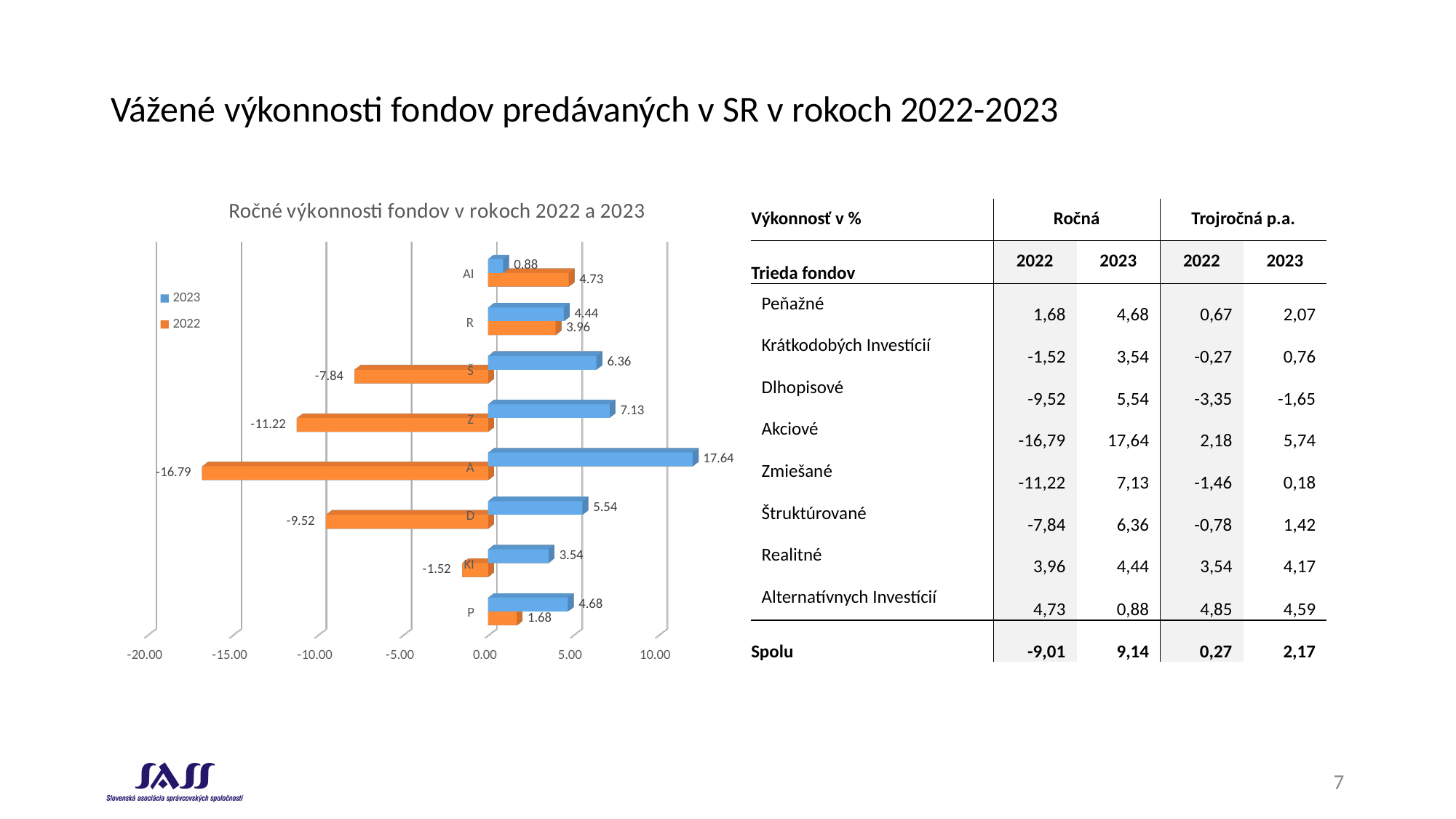
What type of chart is shown on the slide? Bar chart How many series does the chart legend list? 2 What is the 2022 value for category Z in the chart? -11.22 What is the 2023 value for category A in the chart? 17.64 Which category has the lowest 2023 value in the chart? AI What is the 2022 value for category AI in the chart? 4.73 What is the title of the chart on the slide? Ročné výkonnosti fondov v rokoch 2022 a 2023 Which category has the highest 2023 value in the chart? A Which category has the lowest 2022 value in the chart? A Which is larger for category R: the 2023 value or the 2022 value? 2023 How many categories are shown in the chart? 8 What is the difference between the 2023 and 2022 values for category P? 3.00